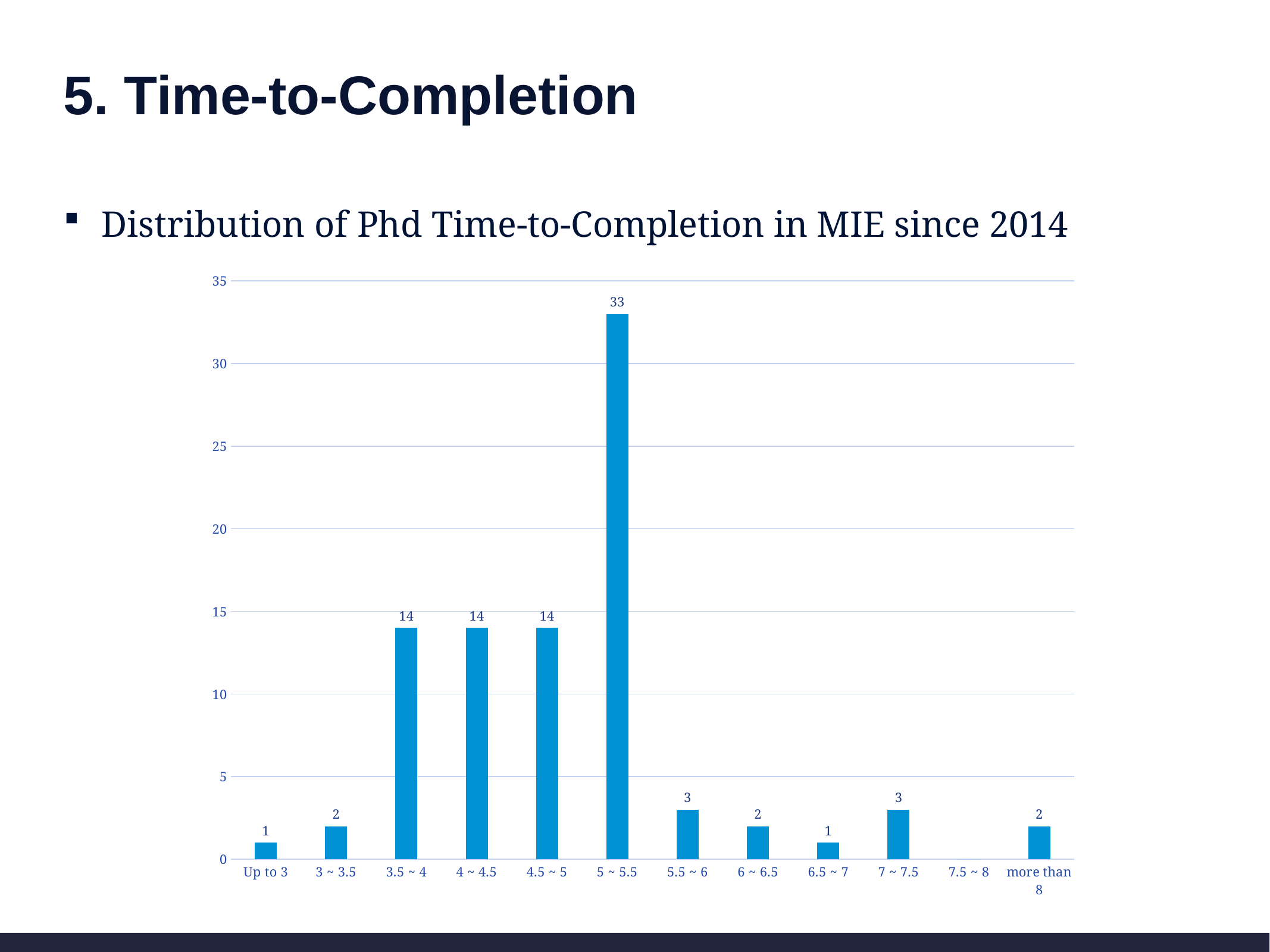
What is the value for the 3.5 ~ 4 category? 14 What is the difference between the values for 5 ~ 5.5 and 4.5 ~ 5? 19 What kind of chart is shown on the slide? Bar chart How many categories are shown on the x axis? 12 What is the difference between the values for 5.5 ~ 6 and 6.5 ~ 7? 2 Which category has the highest value? 5 ~ 5.5 Is the value for 5 ~ 5.5 greater or less than 30? greater What is the value for the 7 ~ 7.5 category? 3 Which category has no bar shown (a value of zero)? 7.5 ~ 8 Which is larger, the value for 3 ~ 3.5 or the value for 7 ~ 7.5? 7 ~ 7.5 What is the value for the 'more than 8' category? 2 What is the value for the 5 ~ 5.5 category? 33